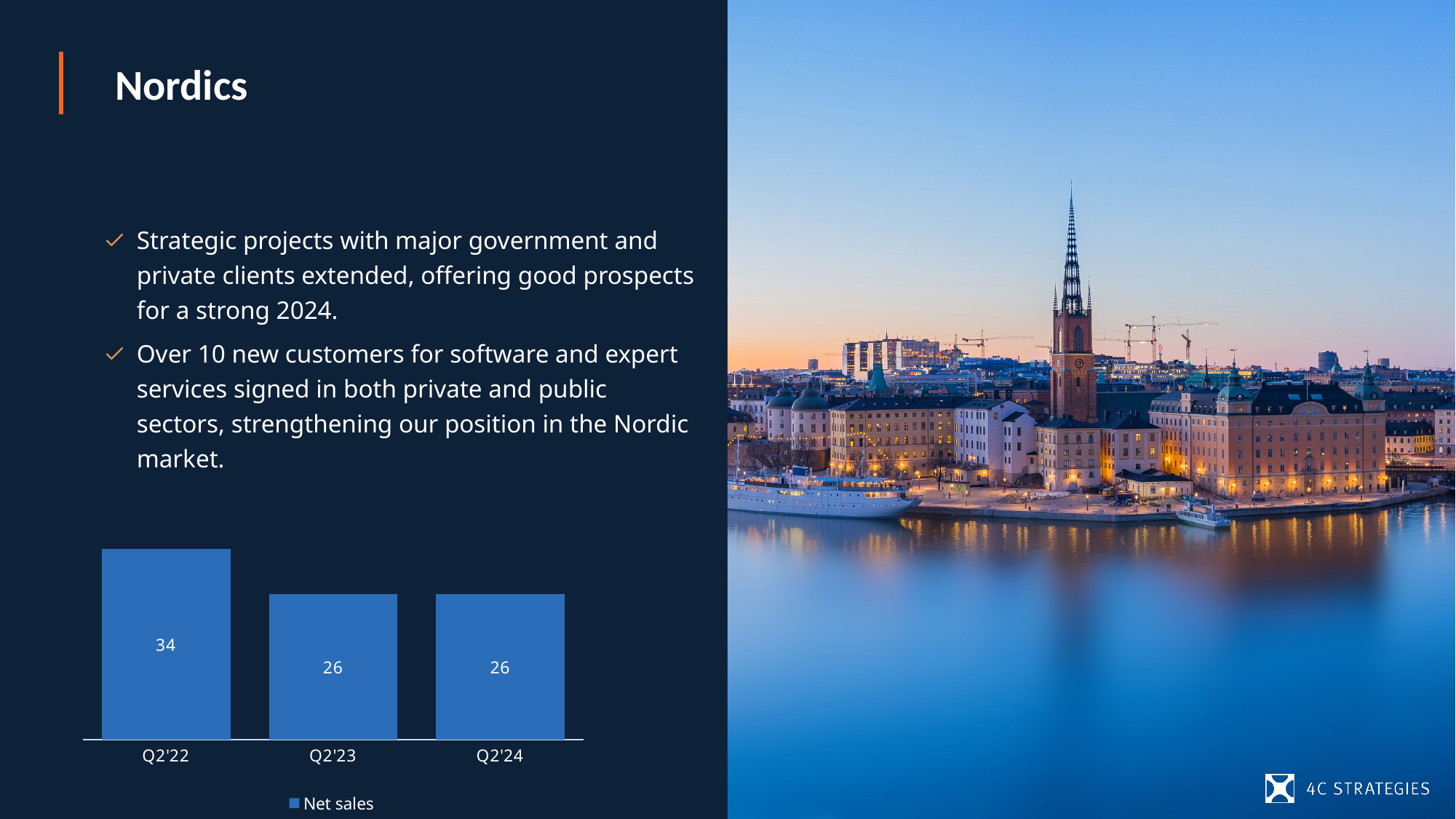
What is the Net sales value for Q2'24? 26 Do Net sales rise or fall from Q2'22 to Q2'23? Fall What series name is shown in the chart legend? Net sales What kind of chart is shown on the slide? Bar chart How many series does the chart legend list? 1 Which quarter has the highest Net sales? Q2'22 Is Net sales larger in Q2'22 or Q2'24? Q2'22 What is the difference in Net sales between Q2'22 and Q2'23? 8 What is the total Net sales across the three quarters shown? 86 What is the Net sales value for Q2'23? 26 What is the Net sales value for Q2'22? 34 How many quarters are shown in the chart? 3